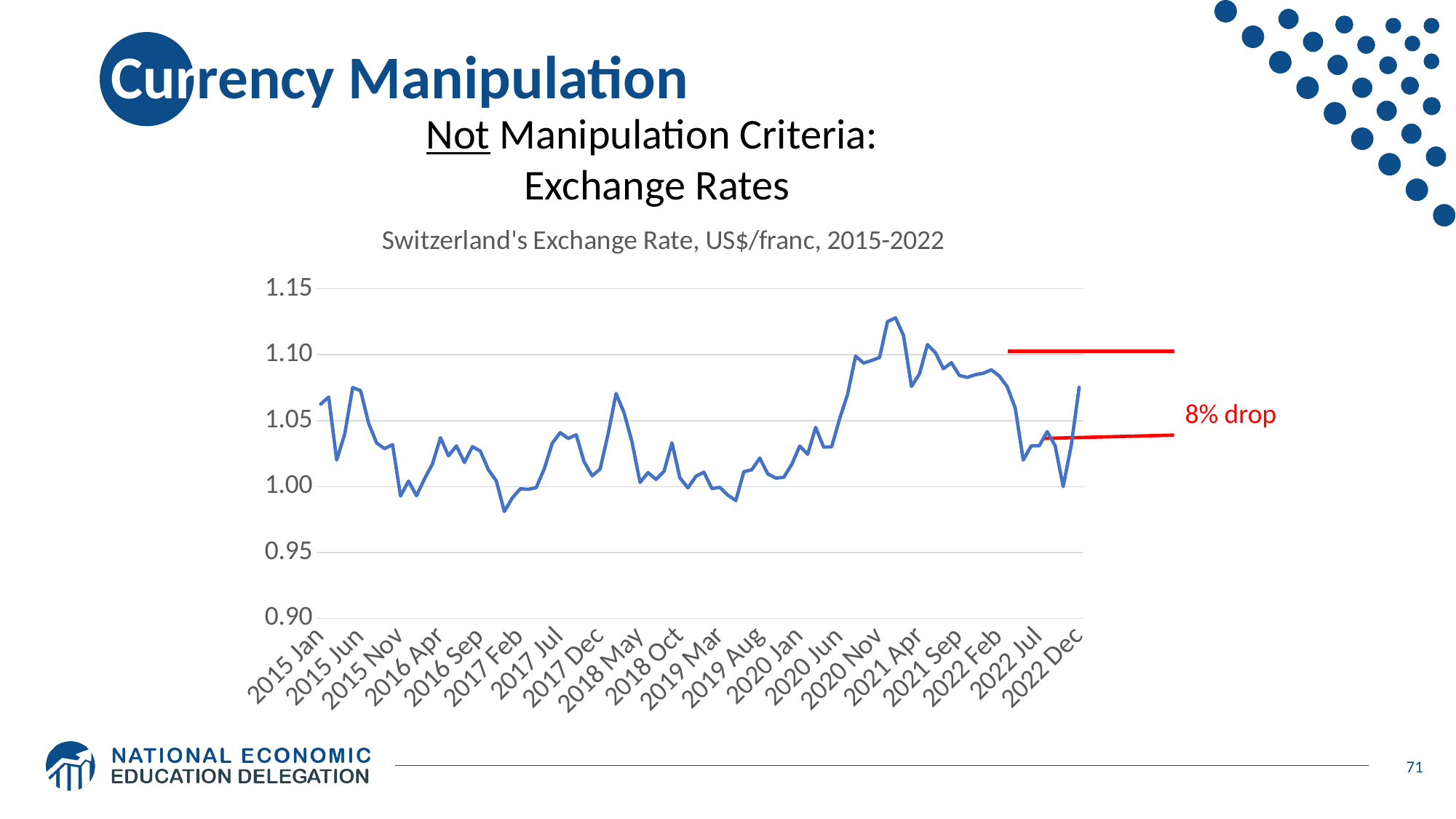
Is the value for 2016 Sep greater or less than 1.05? less What does the red annotation next to the chart say? 8% drop Near which x-axis label does the line reach its lowest point? 2017 Feb Is the value for 2015 Jan greater or less than 1.05? greater Is the lowest point on the line greater or less than 1.00? less Does the exchange rate rise or fall between 2022 Feb and 2022 Jul? fall Which is larger, the value for 2015 Jan or the value for 2017 Feb? 2015 Jan What kind of chart is shown on the slide? line chart Does the exchange rate rise or fall between 2020 Jan and 2020 Nov? rise What is the title of the chart? Switzerland's Exchange Rate, US$/franc, 2015-2022